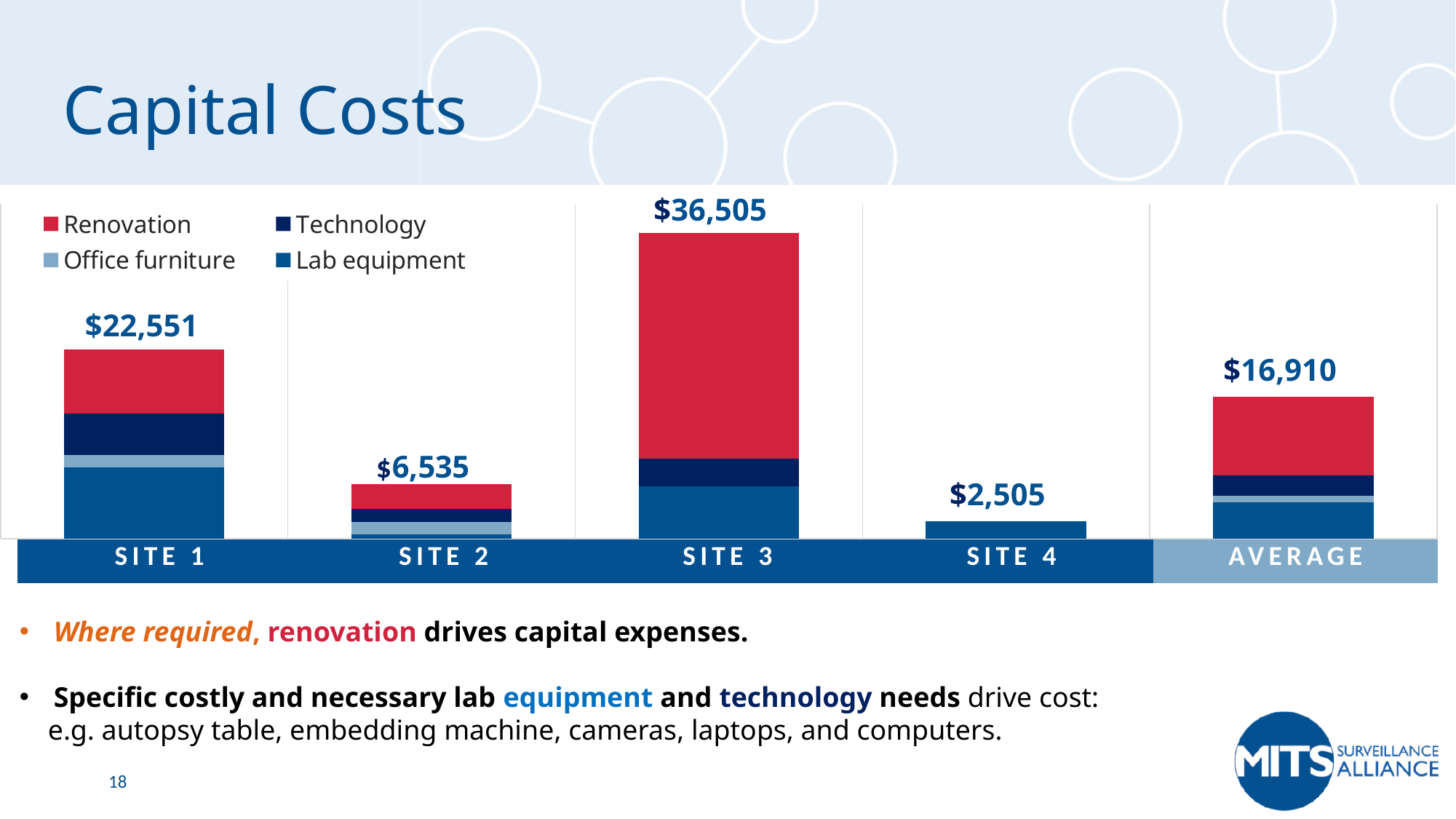
What kind of chart is shown on the slide? Stacked bar chart Which site has the lowest total capital cost? Site 4 What is the total capital cost shown for Site 1? $22,551 What is the total capital cost shown for Site 3? $36,505 How many categories are shown on the x axis of the chart? 5 What is the total capital cost shown for Site 4? $2,505 What is the difference between the total capital costs of Site 2 and Site 4? $4,030 What is the difference between the total capital costs of Site 3 and Site 1? $13,954 Which site has the highest total capital cost? Site 3 Which has a larger total capital cost, Site 2 or the Average? Average What is the average capital cost shown in the chart? $16,910 How many series does the chart legend list? 4